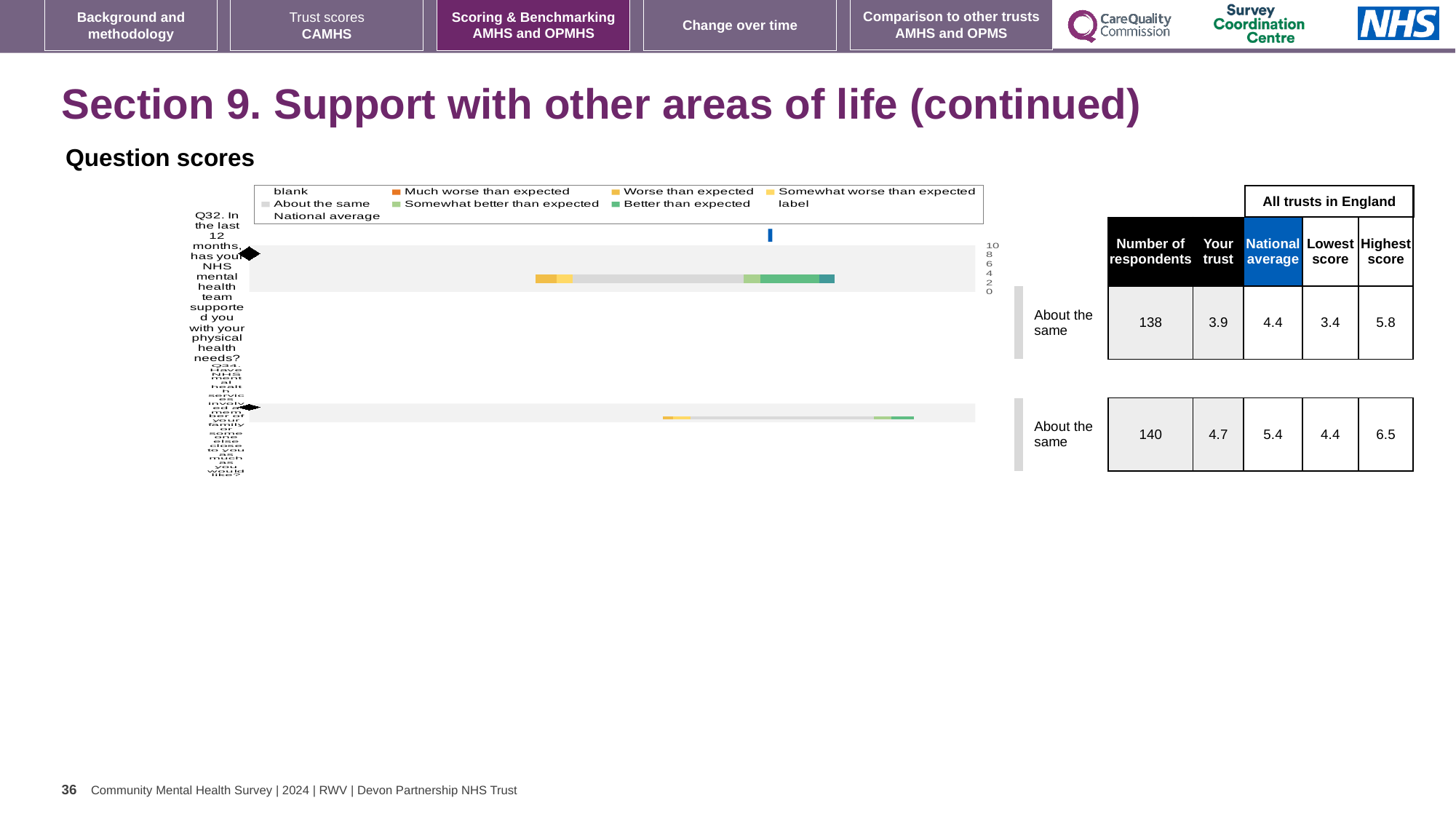
What is the highest tick value shown on the chart's axis? 10 In the table beside the chart, what is the highest score for Q34? 6.5 For Q34, which is larger: the 'Your trust' score or the national average? National average How many question bars are plotted in the chart? 2 What kind of chart is shown under 'Question scores'? bar chart In the table beside the chart, what is the national average for Q32? 4.4 Which question has more respondents, Q32 or Q34? Q34 How many entries does the chart legend list? 9 In the table beside the chart, what is the number of respondents for Q32? 138 What colour represents 'Much worse than expected' in the chart legend? orange For Q32, what is the difference between the highest score and the lowest score? 2.4 In the table beside the chart, what is the 'Your trust' score for Q34? 4.7